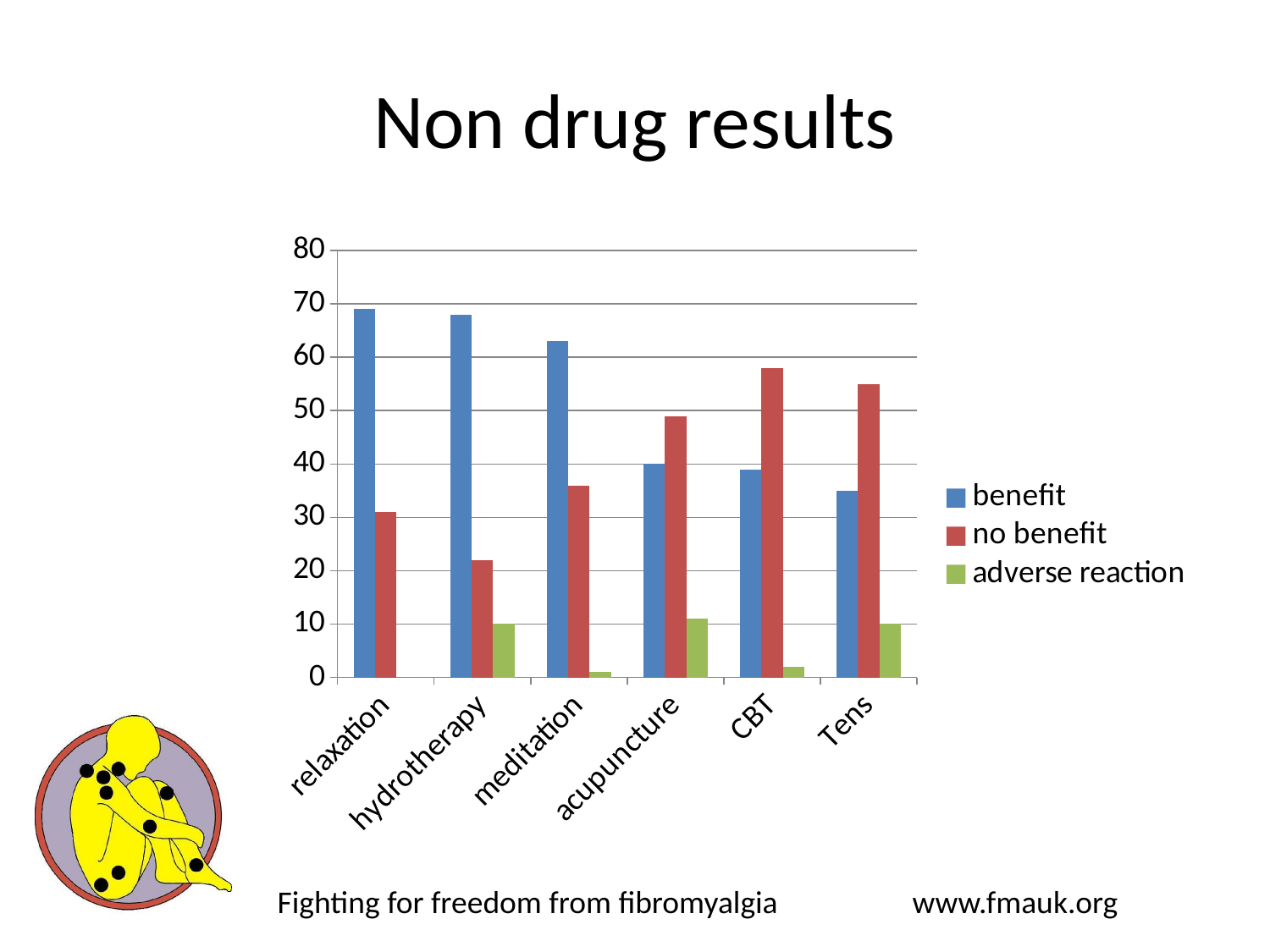
Do the 'benefit' values rise or fall moving from relaxation to Tens along the x axis? fall For relaxation, which is larger: 'benefit' or 'no benefit'? benefit How many series does the legend list? 3 How many treatment categories are shown on the x axis? 6 Which treatment has the lowest 'no benefit' value? hydrotherapy Is the 'benefit' value for relaxation greater or less than 60? greater What colour represents the 'benefit' series in the legend? blue For CBT, which is larger: 'benefit' or 'no benefit'? no benefit What kind of chart is shown on the slide? bar chart Is the 'no benefit' value for hydrotherapy greater or less than 30? less Is the 'adverse reaction' value for meditation greater or less than 10? less